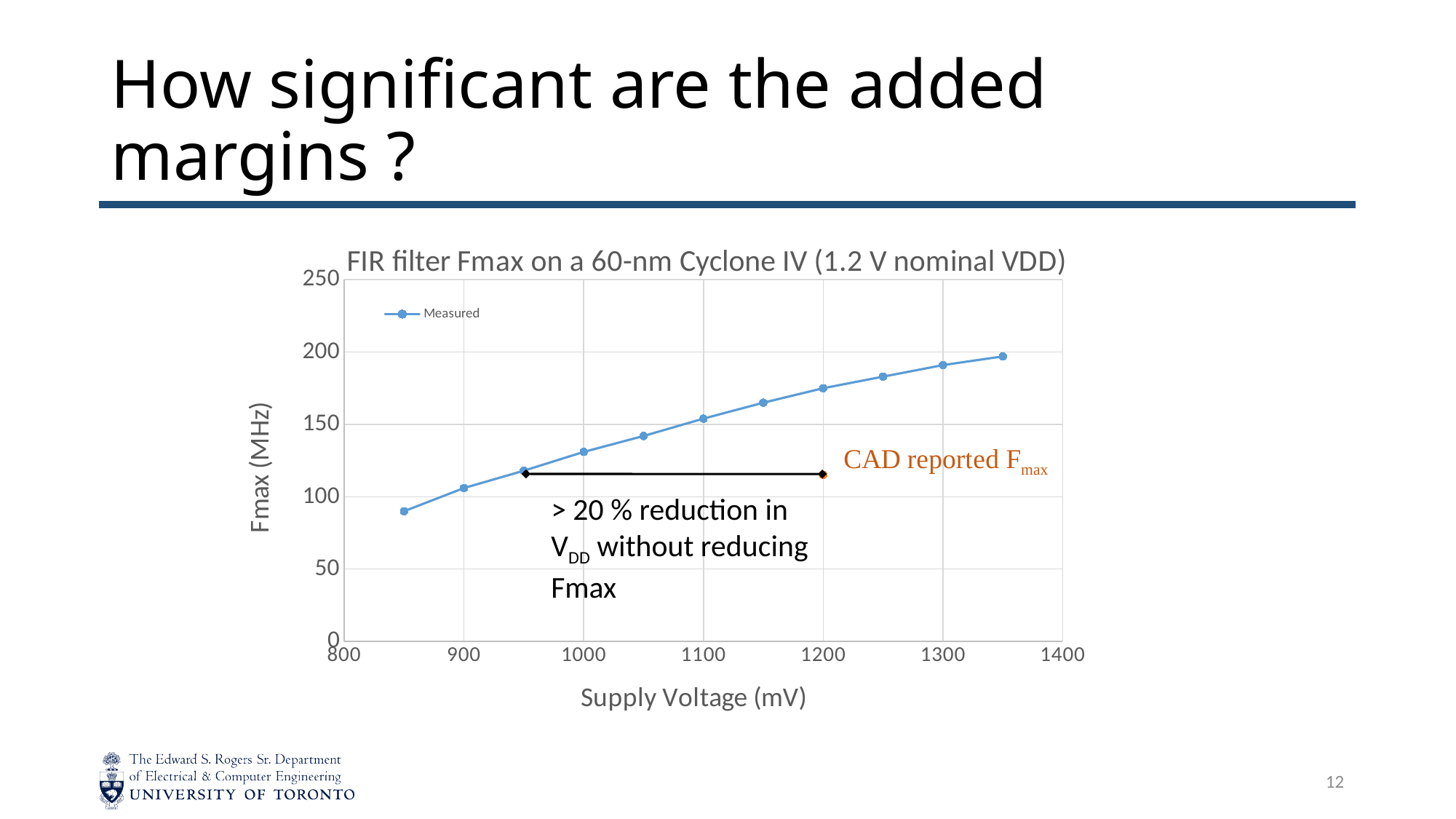
What kind of chart is shown on the slide? line chart Does Fmax rise or fall as supply voltage increases along the x axis? rises What is the title of the chart? FIR filter Fmax on a 60-nm Cyclone IV (1.2 V nominal VDD) How many data points are plotted on the Measured line? 11 How many series does the legend list? 1 What is the label of the x axis? Supply Voltage (mV) At which supply voltage is the measured Fmax lowest? 850 mV Is the measured Fmax at 850 mV greater or less than 100 MHz? less At which supply voltage is the measured Fmax highest? 1350 mV Is the measured Fmax at 1200 mV greater or less than 150 MHz? greater Which has the larger measured Fmax, 1000 mV or 1300 mV? 1300 mV